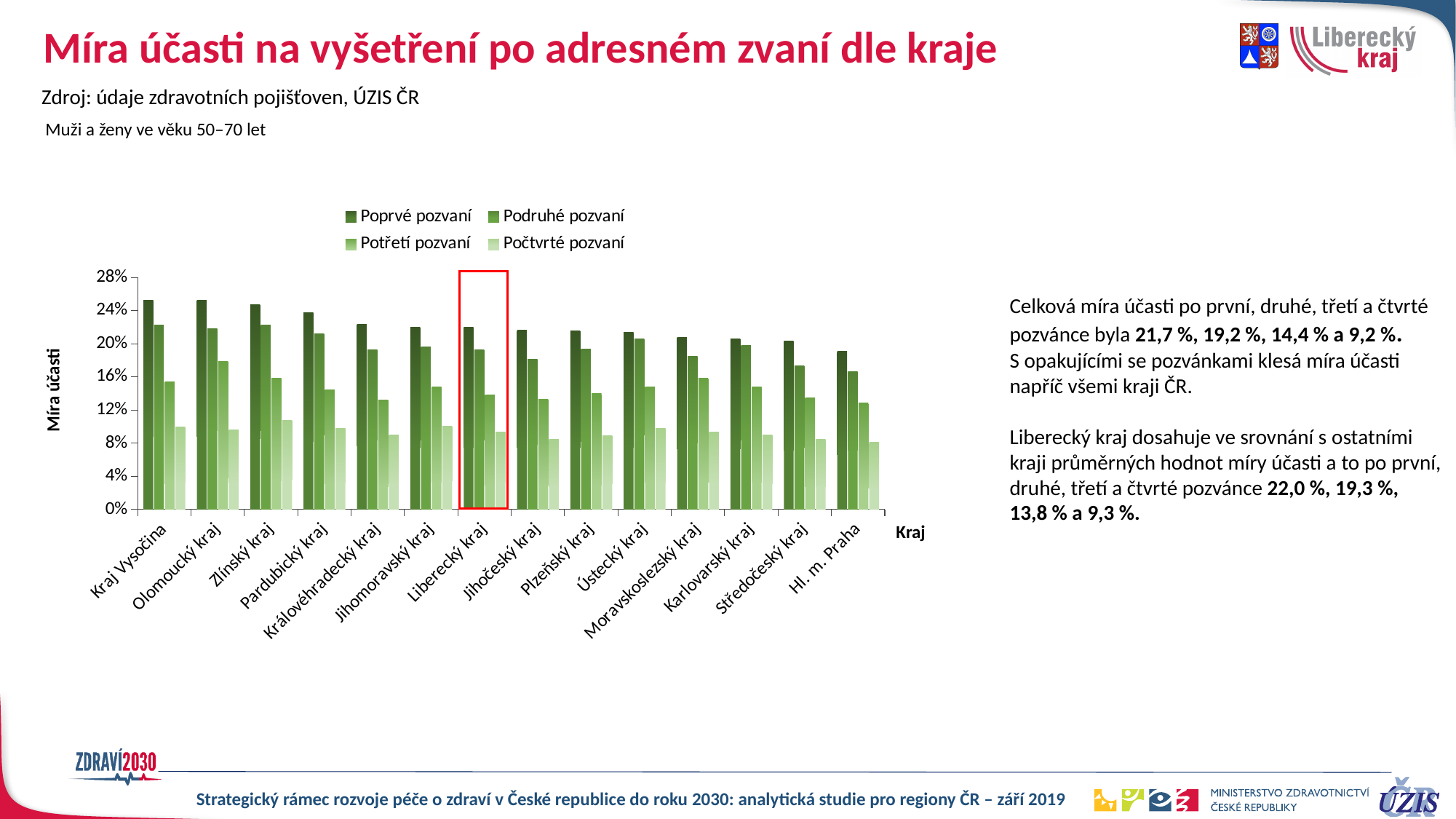
Which is larger: the 'Poprvé pozvaní' value for Kraj Vysočina or for Hl. m. Praha? Kraj Vysočina How many series does the chart legend list? 4 Which region is highlighted with a red box in the chart? Liberecký kraj Is the 'Počtvrté pozvaní' value for Liberecký kraj greater or less than 12%? less Is the 'Poprvé pozvaní' value for Hl. m. Praha greater or less than 20%? less According to the text on the slide, what is the participation rate for Liberecký kraj after the second invitation (podruhé pozvaní)? 19,3 % Which is larger: the 'Potřetí pozvaní' value for Kraj Vysočina or for Olomoucký kraj? Olomoucký kraj Which region has the lowest value for 'Poprvé pozvaní'? Hl. m. Praha What kind of chart is shown on the slide? bar chart Is the 'Poprvé pozvaní' value for Kraj Vysočina greater or less than 24%? greater How many regions (kraje) are shown on the x axis of the chart? 14 Within each region, do the values rise or fall from 'Poprvé pozvaní' to 'Počtvrté pozvaní'? fall